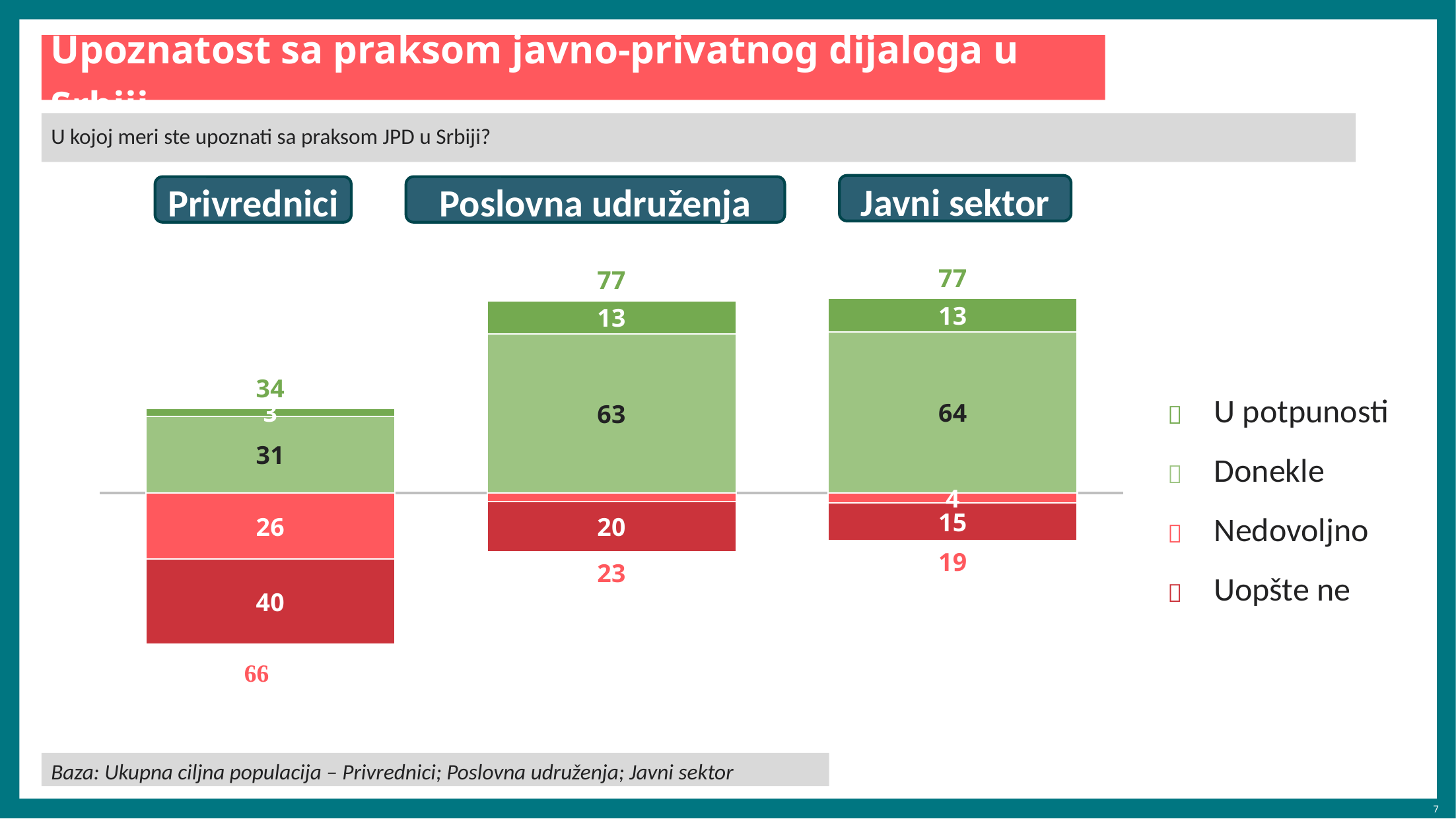
What kind of chart is shown on the slide? Stacked bar chart Which is larger: Uopšte ne for Poslovna udruženja or Uopšte ne for Javni sektor? Poslovna udruženja What is the value for Donekle in the Poslovna udruženja group? 63 What is the difference between the Donekle values for Javni sektor and Privrednici? 33 What is the value for U potpunosti in the Privrednici group? 3 What is the value for Nedovoljno in the Javni sektor group? 4 Which group has the highest value for Uopšte ne? Privrednici How many groups (categories) are shown in the chart? 3 How many series does the legend list? 4 What is the combined total of U potpunosti and Donekle for Javni sektor, as printed above the bar? 77 Which group has the lowest value for Donekle? Privrednici What is the value for Uopšte ne in the Privrednici group? 40